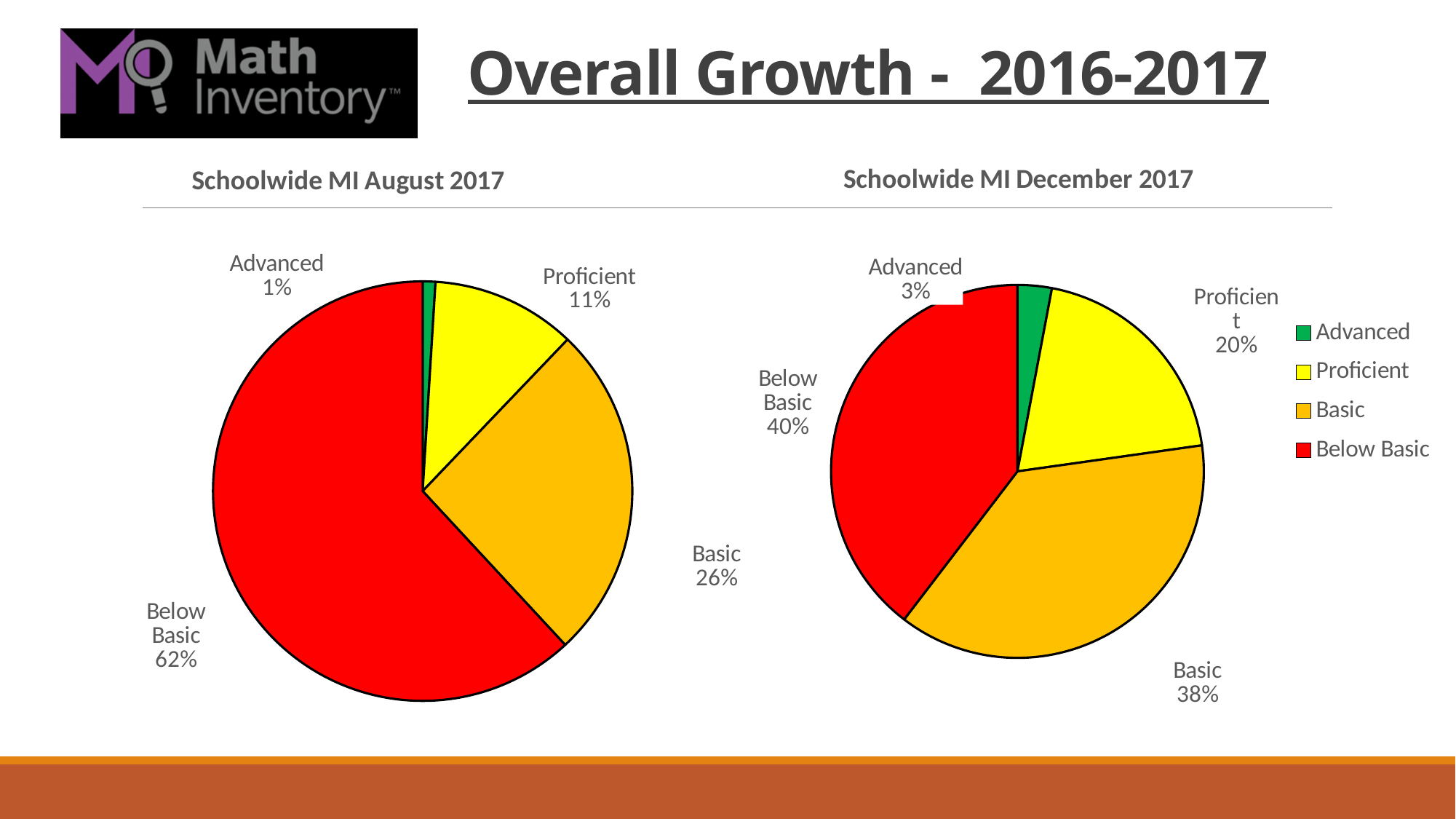
In the 'Schoolwide MI December 2017' chart, what percentage is Basic? 38% In the 'Schoolwide MI December 2017' chart, which is larger: Below Basic or Basic? Below Basic In the 'Schoolwide MI December 2017' chart, which category has the smallest share? Advanced In the 'Schoolwide MI December 2017' chart, what colour represents Below Basic? Red How many categories does the 'Schoolwide MI August 2017' pie chart show? 4 In the 'Schoolwide MI December 2017' chart, what percentage is Proficient? 20% How many entries does the legend next to the 'Schoolwide MI December 2017' chart list? 4 What is the difference between the Below Basic share in the August 2017 chart and the Below Basic share in the December 2017 chart? 22 percentage points In the 'Schoolwide MI August 2017' chart, what percentage is Advanced? 1% What type of chart is 'Schoolwide MI December 2017'? Pie chart In the 'Schoolwide MI August 2017' chart, which category has the largest share? Below Basic In the 'Schoolwide MI August 2017' chart, what percentage is Below Basic? 62%